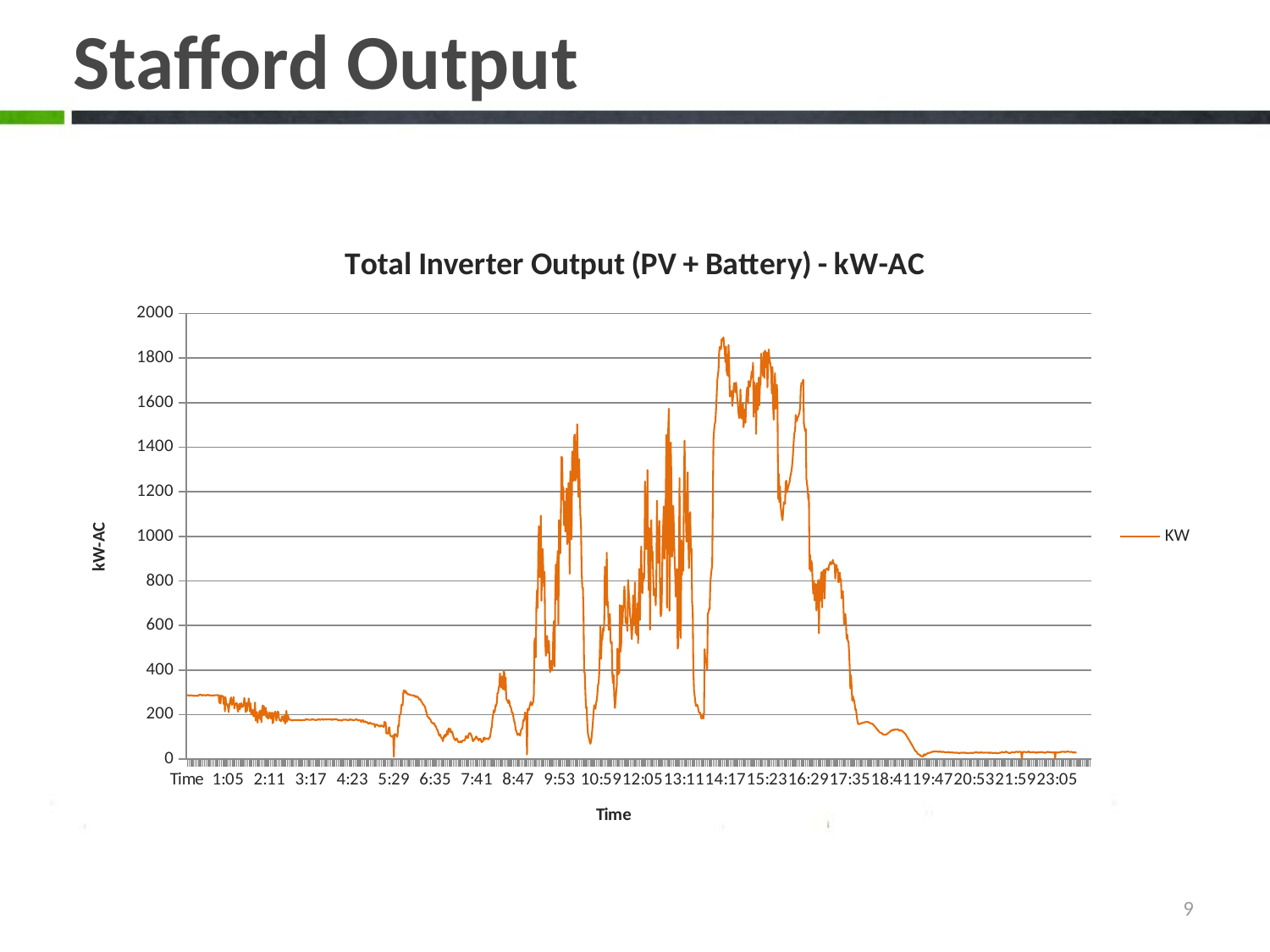
How many series does the legend list? 1 Is the value for 23:05 greater or less than 200? less What kind of chart is shown on the slide? line chart Is the highest value reached by the line greater or less than 1800? greater Is the value for 4:23 greater or less than 400? less What is the label of the series shown in the legend? KW Is the value at 14:17 larger or smaller than the value at 1:05? larger Around which x-axis time label does the line reach its highest value? 14:17 Do the values rise or fall along the x axis between 17:35 and 23:05? fall What is the title of the chart? Total Inverter Output (PV + Battery) - kW-AC